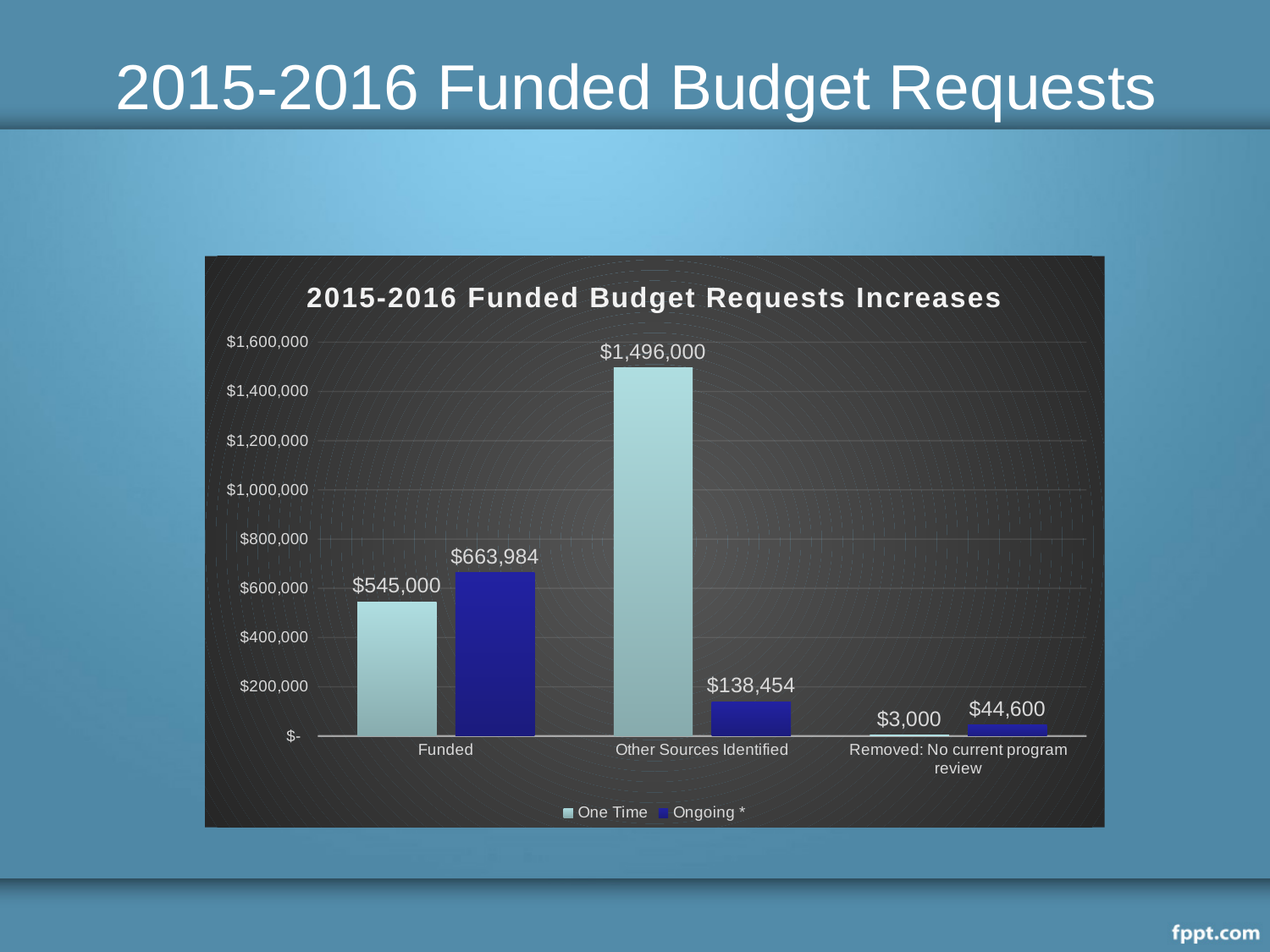
For Other Sources Identified, which is larger: the One Time value or the Ongoing value? One Time What is the One Time value for Funded? $545,000 How many series does the legend list? 2 Which category has the highest One Time value? Other Sources Identified What is the difference between the One Time and Ongoing values for Funded? $118,984 What is the Ongoing value for Other Sources Identified? $138,454 Which category has the lowest Ongoing value? Removed: No current program review What is the title of the chart? 2015-2016 Funded Budget Requests Increases How many categories are shown on the x axis? 3 What is the Ongoing value for Funded? $663,984 What is the One Time value for Removed: No current program review? $3,000 What kind of chart is shown? Bar chart